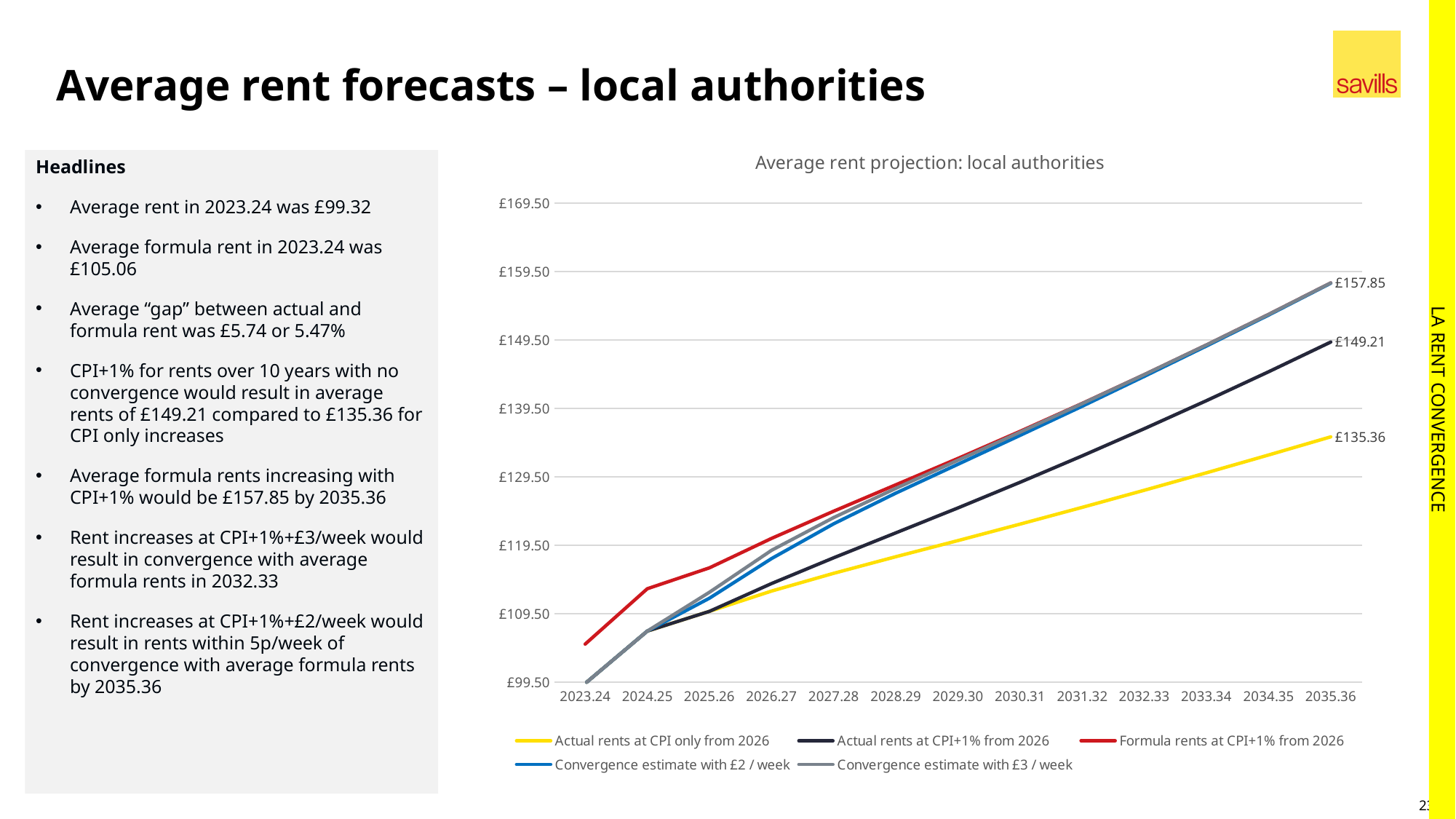
What is the difference in 2035.36 between 'Actual rents at CPI+1% from 2026' and 'Actual rents at CPI only from 2026'? £13.85 What is the title of the chart? Average rent projection: local authorities What kind of chart is shown on the slide? Line chart What is the value of 'Actual rents at CPI only from 2026' in 2035.36? £135.36 Do the values of the series rise or fall from 2023.24 to 2035.36? Rise Which series has the lowest value in 2035.36? Actual rents at CPI only from 2026 How many years are shown along the x axis of the chart? 13 Is the value for 'Actual rents at CPI only from 2026' in 2030.31 greater or less than £129.50? less How many series does the legend of the chart list? 5 What is the value of 'Actual rents at CPI+1% from 2026' in 2035.36? £149.21 What is the value of 'Formula rents at CPI+1% from 2026' in 2035.36? £157.85 What is the difference in 2035.36 between 'Formula rents at CPI+1% from 2026' and 'Actual rents at CPI+1% from 2026'? £8.64